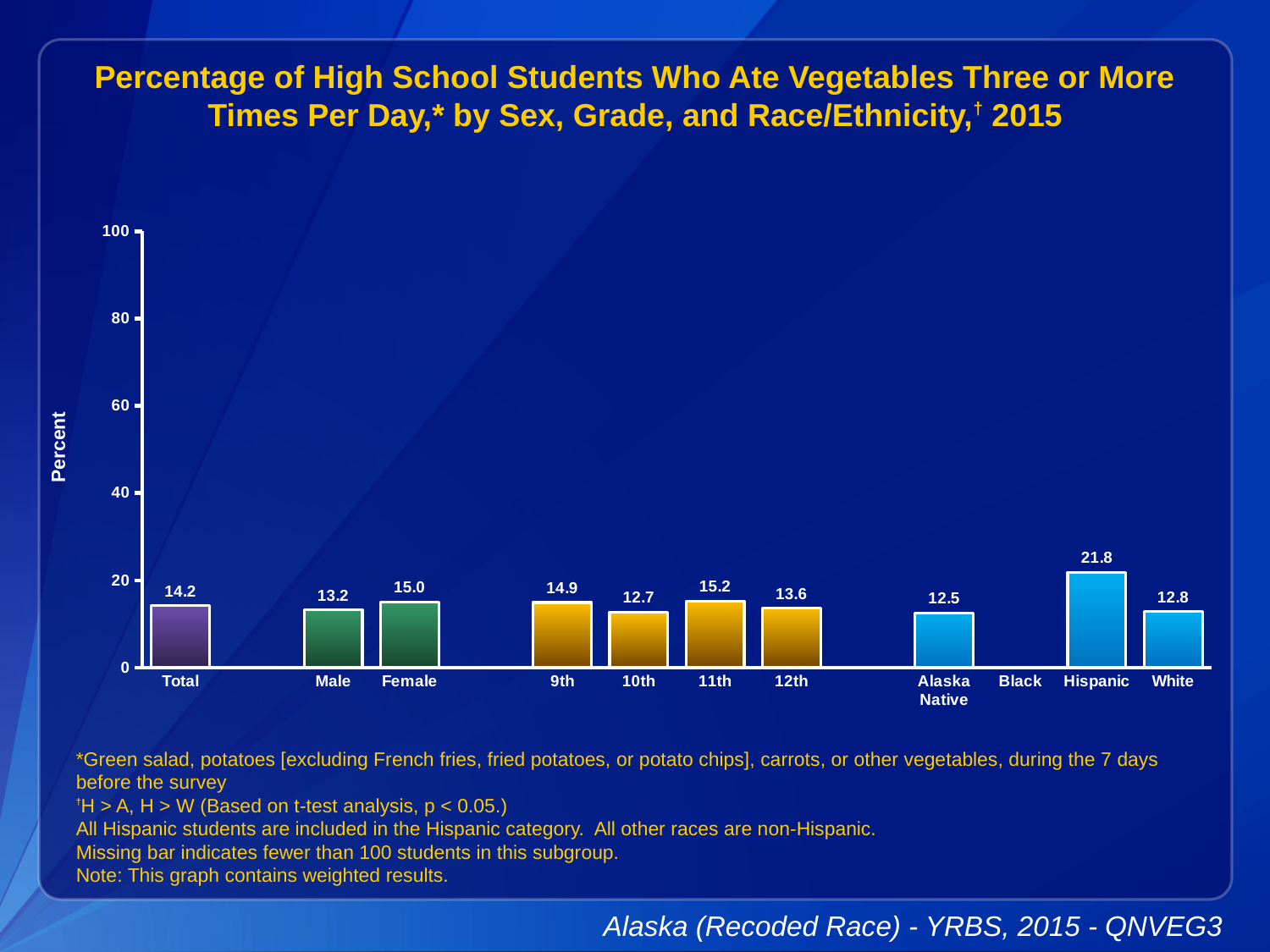
What is the value shown for Female students? 15.0 How many grade categories are shown on the chart? 4 Is the value for White students greater or less than 20? less What percentage of high school students in total ate vegetables three or more times per day? 14.2 What kind of chart is shown on the slide? bar chart What is the value shown for 10th grade students? 12.7 Which category has the highest value on the chart? Hispanic Which race/ethnicity category has no bar plotted? Black Which has a higher value, 11th grade or 12th grade? 11th Which category has the lowest value on the chart? Alaska Native What is the difference between the values for Female and Male students? 1.8 What is the value shown for Hispanic students? 21.8